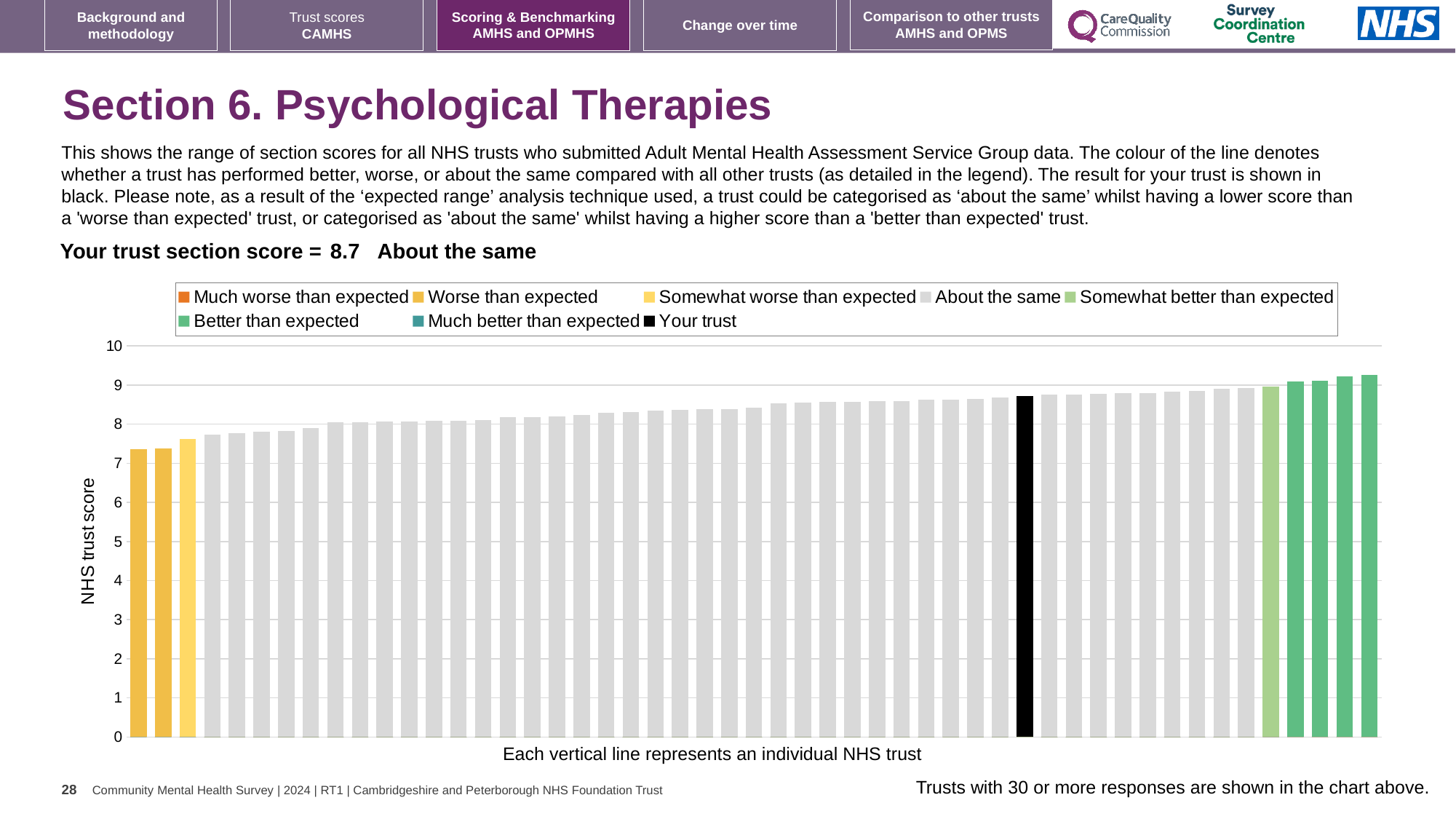
Is the value of the lowest bar on the chart greater or less than 8? less What is the section score for your trust shown on the chart? 8.7 Is the value of the highest bar on the chart greater or less than 9? greater Which category is your trust placed in according to the text above the chart? About the same How many bars are coloured as 'Better than expected' (dark green)? 4 Do the bar values rise or fall from left to right along the x axis? rise What kind of chart is shown on the slide? bar chart What is the label on the vertical axis of the chart? NHS trust score How many bars are coloured as 'Worse than expected' (orange-yellow)? 2 What colour is the bar representing your trust? black How many entries does the chart legend list? 8 Is the value of the black bar (your trust) greater or less than 8? greater